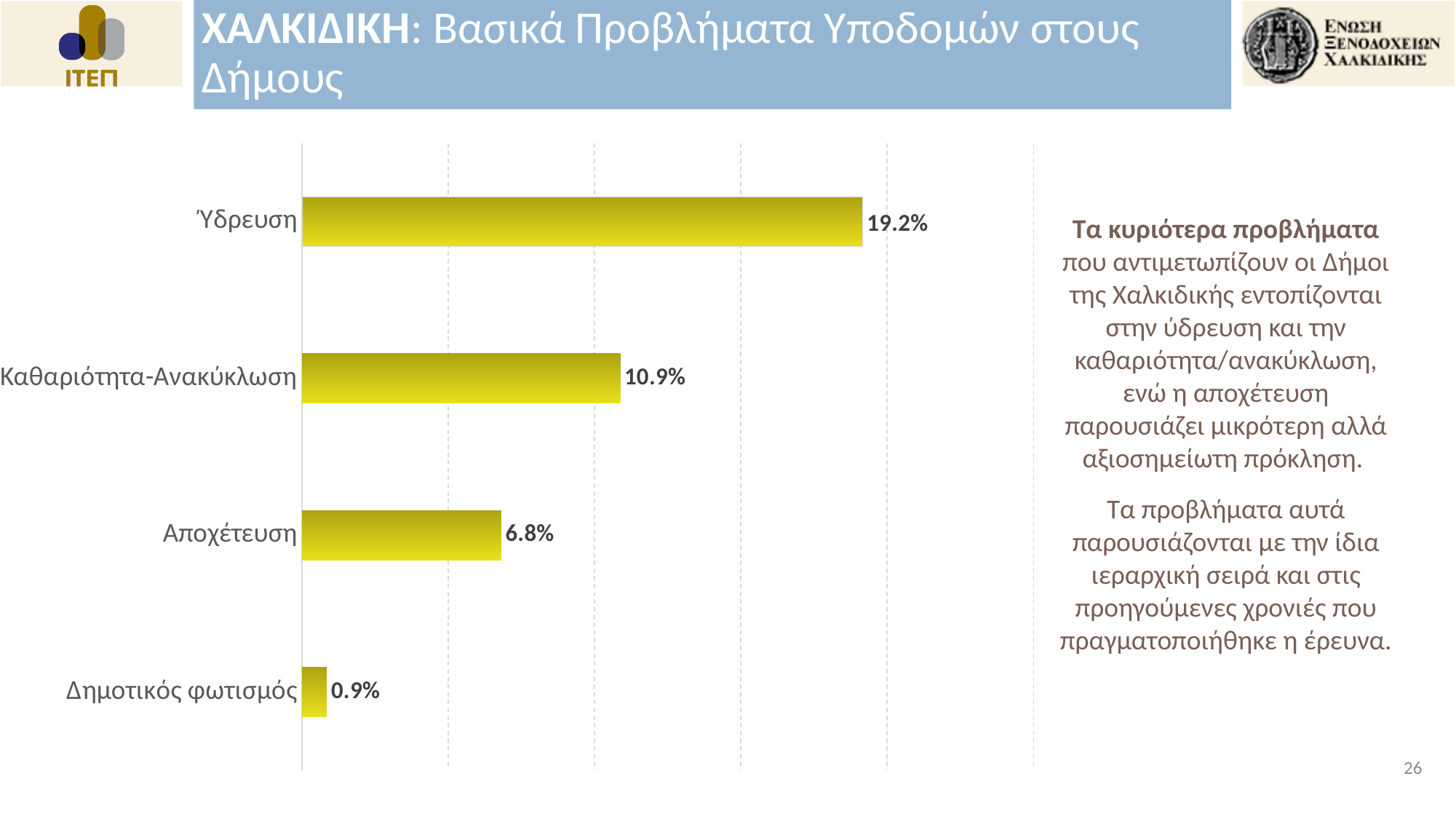
What is the value for Καθαριότητα-Ανακύκλωση? 10.9% What kind of chart is shown on the slide? Bar chart What is the value for Ύδρευση? 19.2% Which category has the lowest value? Δημοτικός φωτισμός What is the difference between the values for Ύδρευση and Καθαριότητα-Ανακύκλωση? 8.3% Which category has the highest value? Ύδρευση What is the difference between the values for Αποχέτευση and Δημοτικός φωτισμός? 5.9% What colour are the bars in the chart? Yellow Which is larger, the value for Καθαριότητα-Ανακύκλωση or the value for Αποχέτευση? Καθαριότητα-Ανακύκλωση What is the value for Δημοτικός φωτισμός? 0.9% How many categories are shown in the chart? 4 What is the value for Αποχέτευση? 6.8%